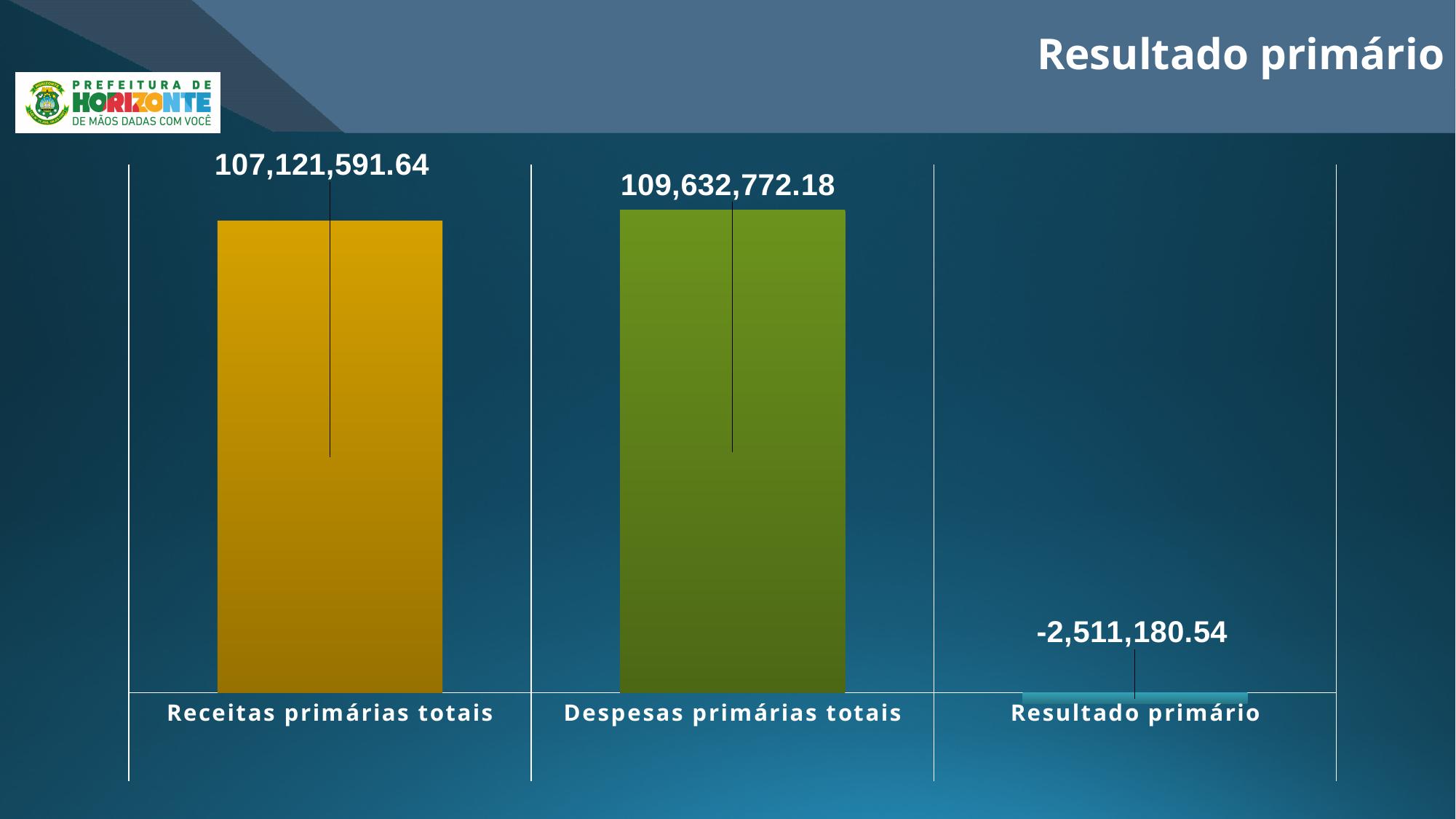
What is the title of the slide? Resultado primário Is the value for Resultado primário positive or negative? Negative What is the value for Receitas primárias totais? 107,121,591.64 What is the value for Resultado primário? -2,511,180.54 What colour is the bar for Receitas primárias totais? Yellow/gold Which category has the lowest value? Resultado primário What is the difference between Despesas primárias totais and Receitas primárias totais? 2,511,180.54 Which category has the highest value? Despesas primárias totais How many categories are shown in the chart? 3 What kind of chart is shown on the slide? Bar chart Which is larger, Receitas primárias totais or Despesas primárias totais? Despesas primárias totais What is the value for Despesas primárias totais? 109,632,772.18